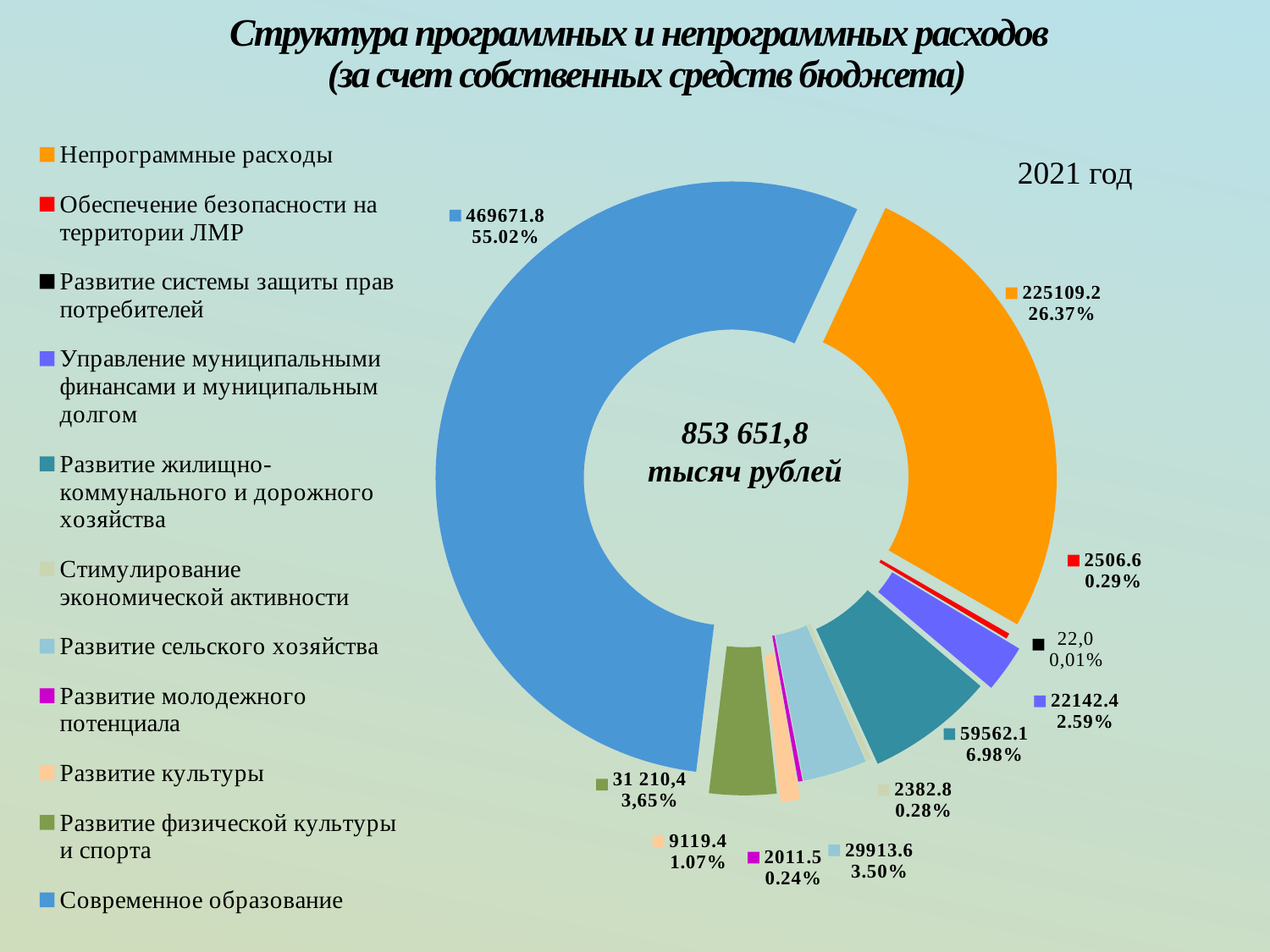
Which category has the smallest share of the chart? Развитие системы защиты прав потребителей What is the difference between the values for Непрограммные расходы and Управление муниципальными финансами и муниципальным долгом? 202966.8 What total amount is shown in the centre of the chart? 853 651,8 тысяч рублей How many categories does the legend list? 11 What share of the chart does Непрограммные расходы represent? 26.37% What share of the chart does Развитие физической культуры и спорта represent? 3,65% Which year does the chart refer to? 2021 год What is the value for Развитие жилищно-коммунального и дорожного хозяйства? 59562.1 Which is larger: Развитие сельского хозяйства or Развитие культуры? Развитие сельского хозяйства What is the value for Современное образование? 469671.8 Which category has the largest share of the chart? Современное образование What kind of chart is shown on the slide? Doughnut (pie) chart